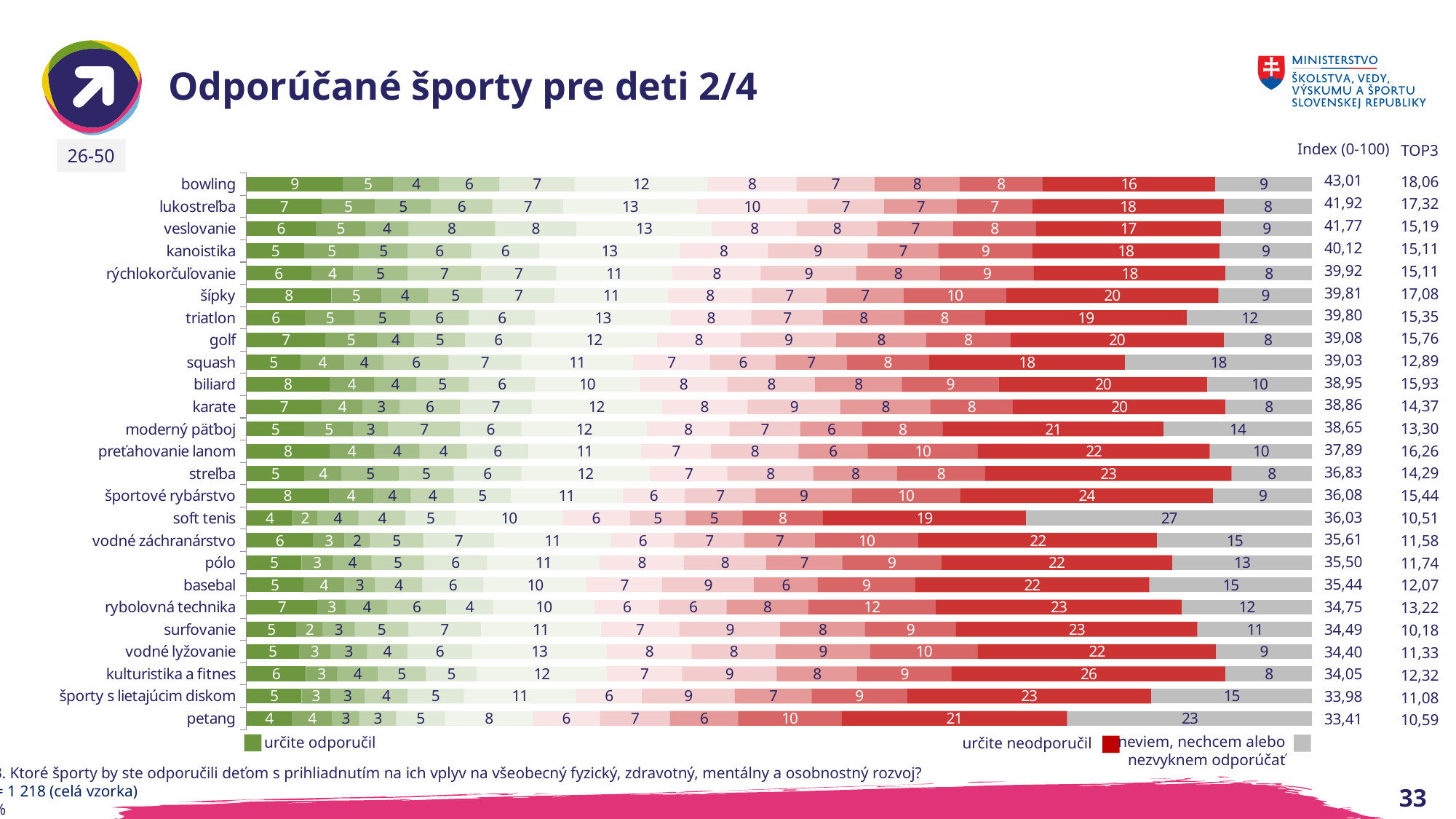
Which has a larger 'určite odporučil' value, bowling or šípky? bowling What is the Index (0-100) value for bowling? 43,01 Which sport has the lowest TOP3 value? surfovanie Which sport has the lowest Index (0-100) value? petang What is the TOP3 value for petang? 10,59 Which sport has the highest Index (0-100) value? bowling What kind of chart is shown on the slide? stacked bar chart How many sports are listed in the chart? 25 What is the first legend entry shown below the chart? určite odporučil Which sport has the largest 'určite neodporučil' (dark red) segment? kulturistika a fitnes What is the value of the grey 'neviem, nechcem alebo nezvyknem odporúčať' segment for soft tenis? 27 What is the difference between the Index (0-100) values of bowling and petang? 9,60